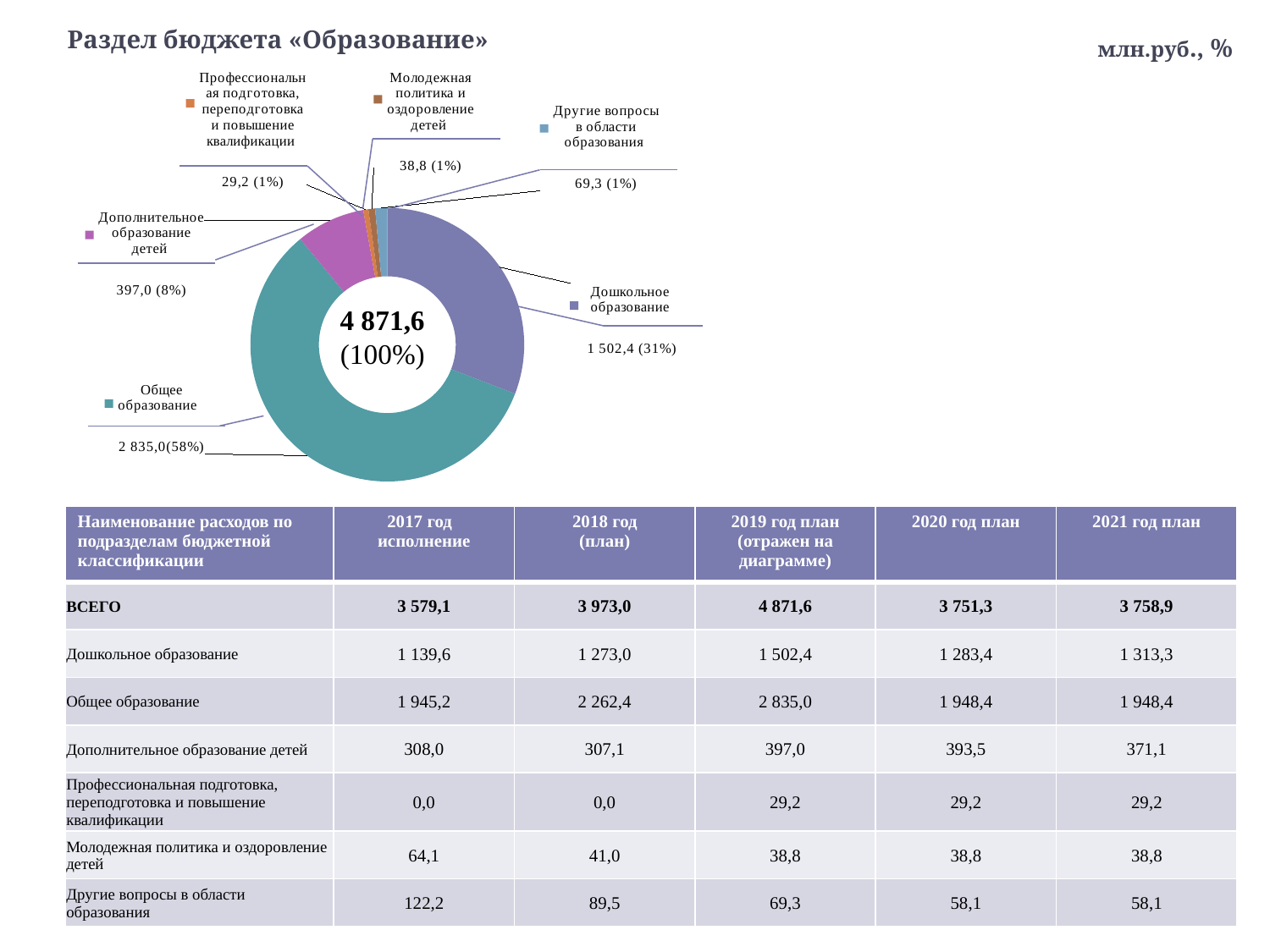
What is the value shown for Дополнительное образование детей in the pie chart? 397,0 Which category has the smallest slice in the pie chart? Профессиональная подготовка, переподготовка и повышение квалификации What share of the pie does Дошкольное образование represent? 31% How many categories does the pie chart show? 6 What is the value shown for Дошкольное образование in the pie chart? 1 502,4 Which category has the largest slice in the pie chart? Общее образование What share of the pie does Общее образование represent? 58% What is the difference between the values for Общее образование and Дошкольное образование in the pie chart? 1 332,6 What is the value shown for Другие вопросы в области образования in the pie chart? 69,3 What is the value shown for Общее образование in the pie chart? 2 835,0 What total value is shown in the centre of the pie chart? 4 871,6 What kind of chart is shown on the slide? Pie (donut) chart